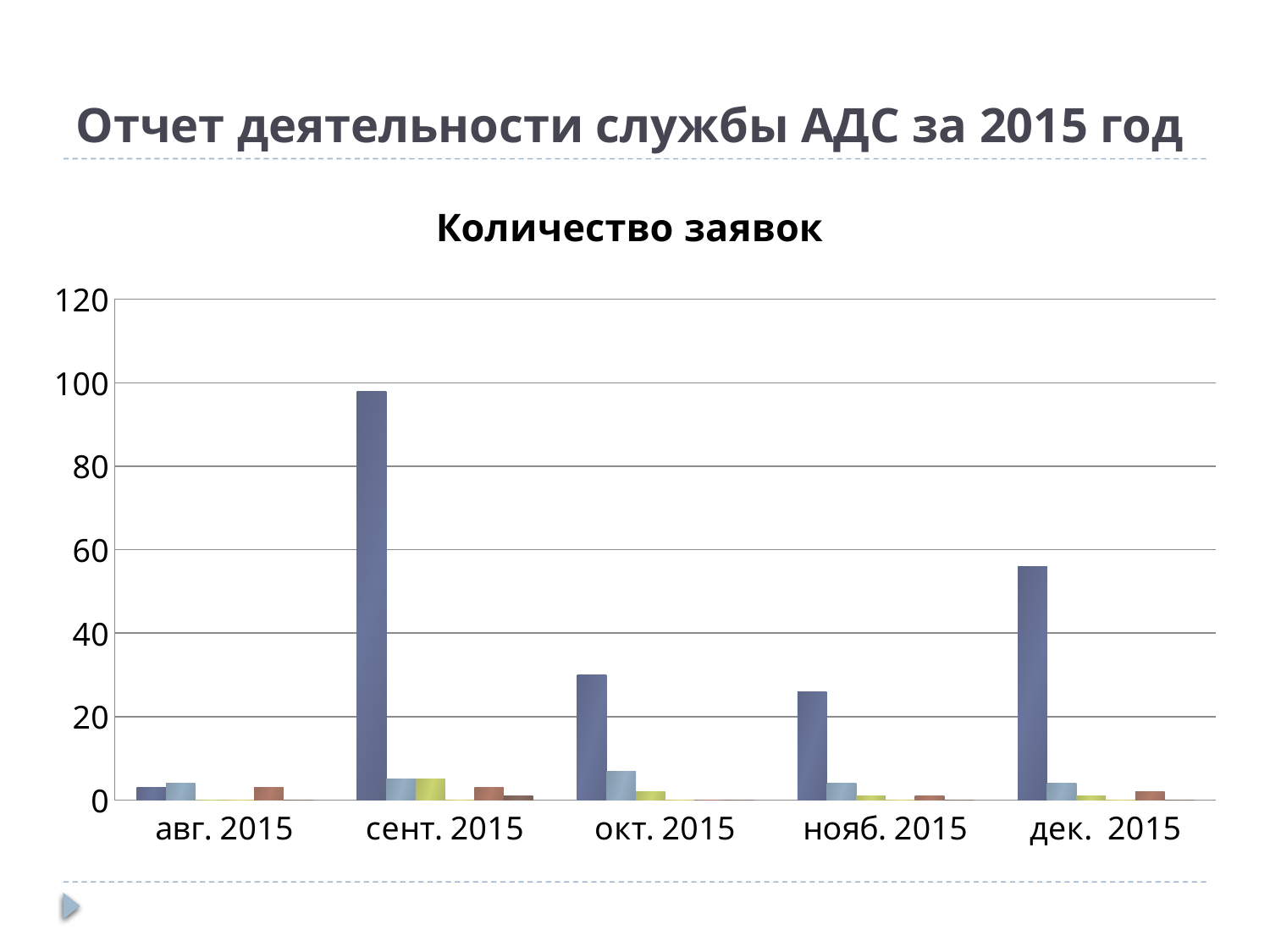
Is the dark blue bar for авг. 2015 greater or less than 20? less Is the dark blue bar for дек. 2015 greater or less than 40? greater Which is larger, the dark blue bar for сент. 2015 or for дек. 2015? сент. 2015 Does the dark blue series rise or fall from сент. 2015 to нояб. 2015? fall What is the title of the chart? Количество заявок How many months (categories) are shown on the x axis? 5 Is the dark blue bar for окт. 2015 greater or less than 40? less What kind of chart is shown on the slide? bar chart Which month has the shortest dark blue bar? авг. 2015 Which is larger, the dark blue bar for дек. 2015 or for окт. 2015? дек. 2015 Which month has the tallest dark blue bar? сент. 2015